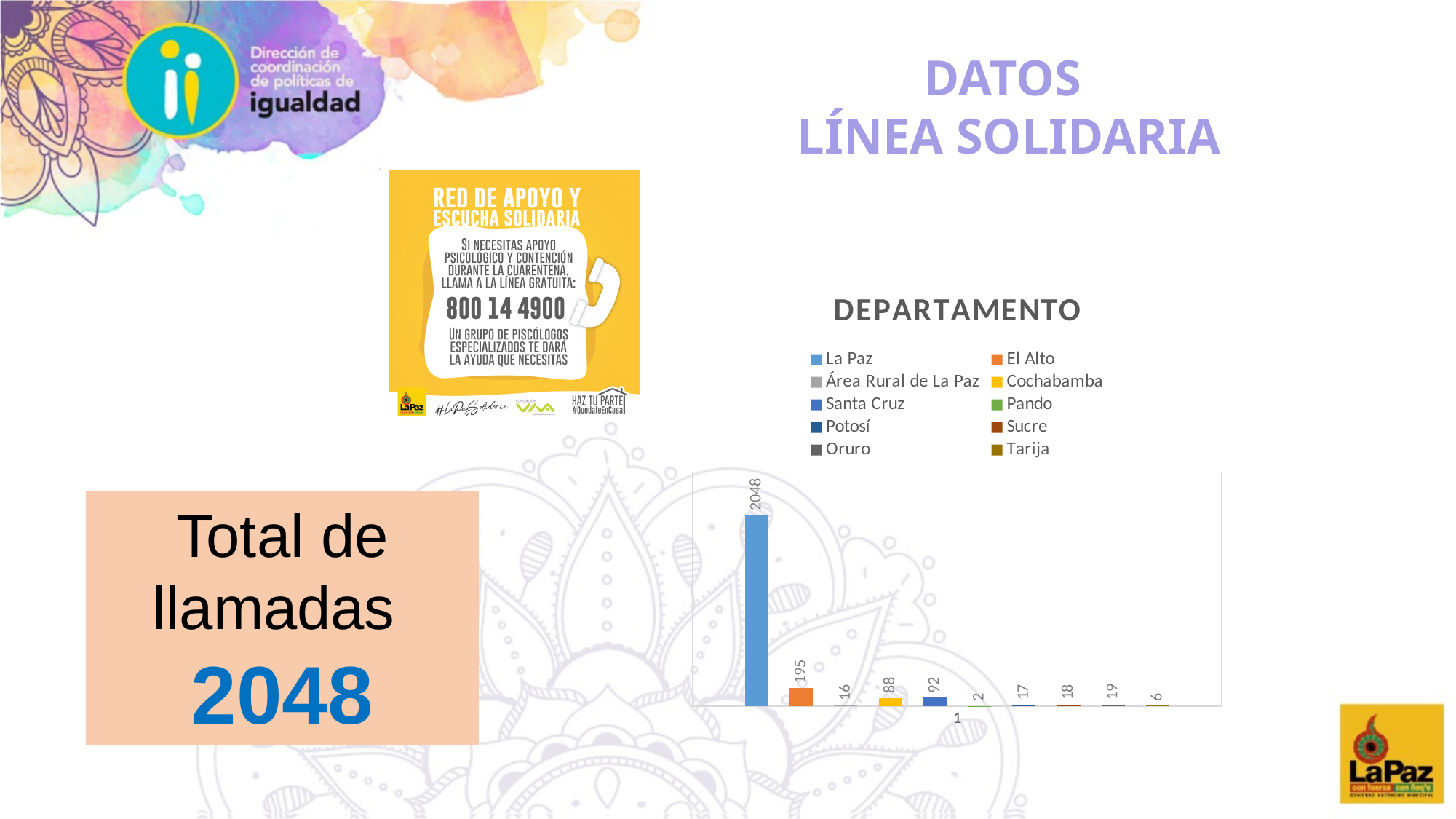
What is the title of the chart on the slide? DEPARTAMENTO What is the value for Cochabamba in the DEPARTAMENTO chart? 88 What is the value for El Alto in the DEPARTAMENTO chart? 195 What is the value for Santa Cruz in the DEPARTAMENTO chart? 92 Which department has the lowest value in the DEPARTAMENTO chart? Pando What is the value for La Paz in the DEPARTAMENTO chart? 2048 What is the value for Pando in the DEPARTAMENTO chart? 2 How many series does the legend of the DEPARTAMENTO chart list? 10 What kind of chart is the DEPARTAMENTO chart? Bar chart Which is larger in the DEPARTAMENTO chart, the value for Santa Cruz or the value for Cochabamba? Santa Cruz What is the difference between the values for La Paz and El Alto in the DEPARTAMENTO chart? 1853 Which department has the highest value in the DEPARTAMENTO chart? La Paz